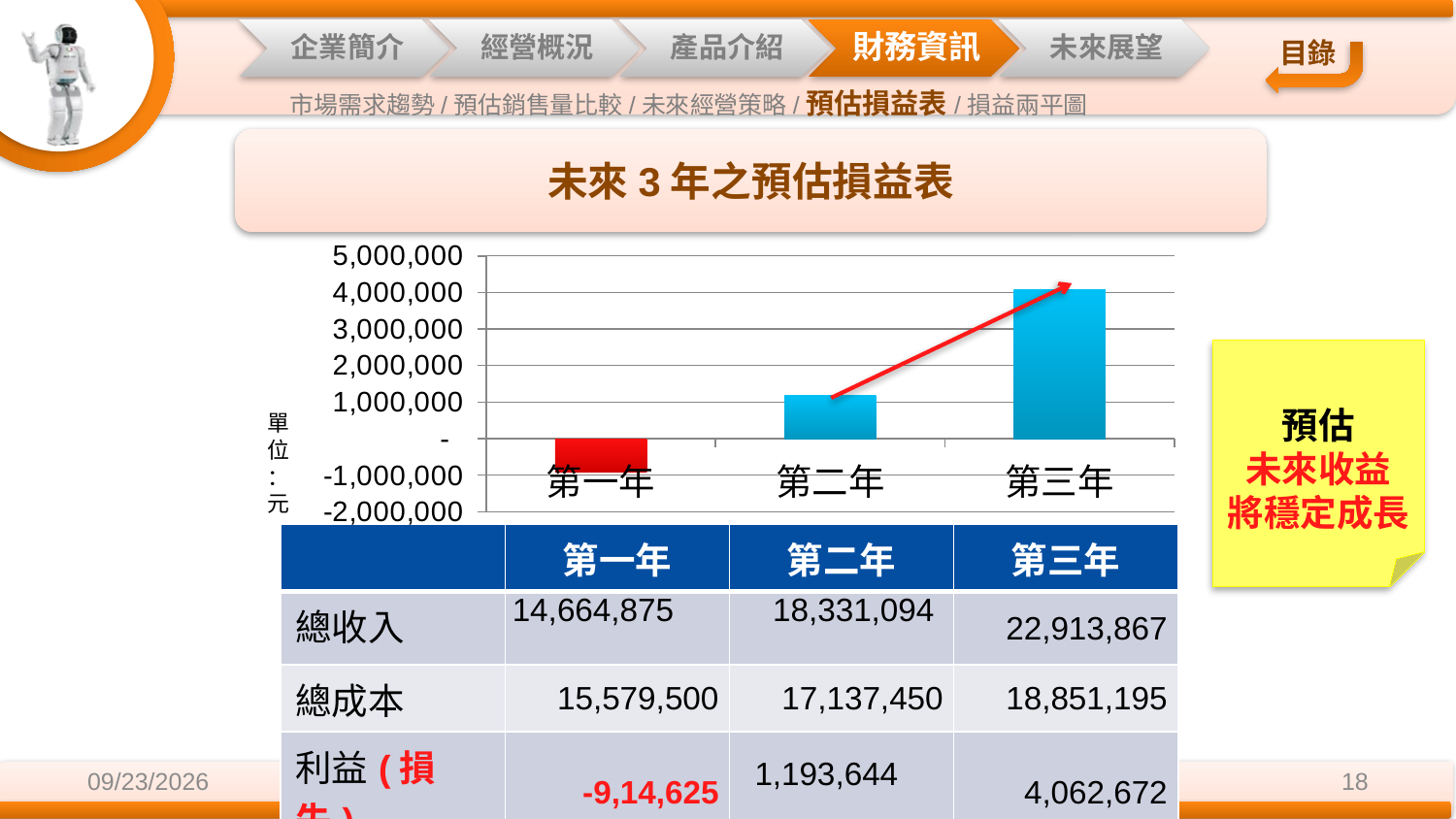
What kind of chart is shown on the slide? bar chart Which is larger, the bar for 第二年 or the bar for 第三年? 第三年 Is the value for 第二年 greater or less than 1,000,000? greater What is the title shown above the chart? 未來 3 年之預估損益表 How many categories (years) are plotted on the x axis of the chart? 3 Is the value for 第三年 greater or less than 3,000,000? greater Is the value for 第一年 greater or less than 0? less According to the table below the chart, what is the 利益 for 第二年? 1,193,644 Which year has the highest bar in the chart? 第三年 Which year has the lowest bar in the chart? 第一年 According to the table below the chart, what is the 利益 for 第三年? 4,062,672 Do the bar values rise or fall from 第一年 to 第三年? rise